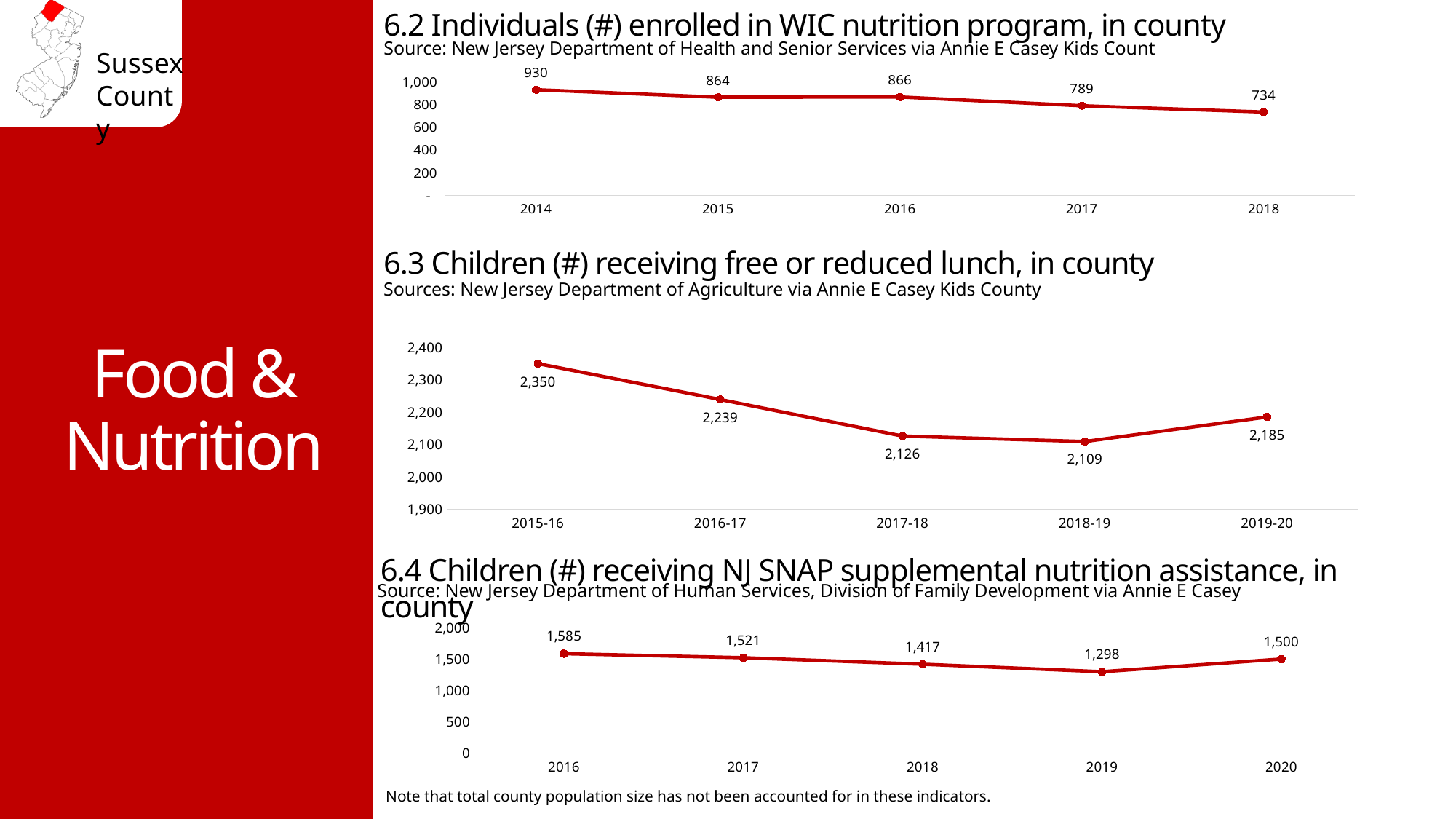
In the chart '6.3 Children (#) receiving free or reduced lunch, in county', is the value for 2019-20 larger or smaller than the value for 2016-17? smaller In the chart '6.4 Children (#) receiving NJ SNAP supplemental nutrition assistance, in county', which year has the lowest value? 2019 What kind of chart is '6.3 Children (#) receiving free or reduced lunch, in county'? line chart In the chart '6.2 Individuals (#) enrolled in WIC nutrition program, in county', which year has the lowest value? 2018 In the chart '6.4 Children (#) receiving NJ SNAP supplemental nutrition assistance, in county', what is the value for 2020? 1,500 In the chart '6.3 Children (#) receiving free or reduced lunch, in county', what is the value for 2018-19? 2,109 In the chart '6.2 Individuals (#) enrolled in WIC nutrition program, in county', how many years are plotted? 5 In the chart '6.4 Children (#) receiving NJ SNAP supplemental nutrition assistance, in county', what is the difference between the 2016 and 2019 values? 287 In the chart '6.3 Children (#) receiving free or reduced lunch, in county', which school year has the highest value? 2015-16 In the chart '6.2 Individuals (#) enrolled in WIC nutrition program, in county', do the values generally rise or fall from 2014 to 2018? fall In the chart '6.2 Individuals (#) enrolled in WIC nutrition program, in county', what is the difference between the 2014 and 2018 values? 196 In the chart '6.2 Individuals (#) enrolled in WIC nutrition program, in county', what is the value for 2014? 930